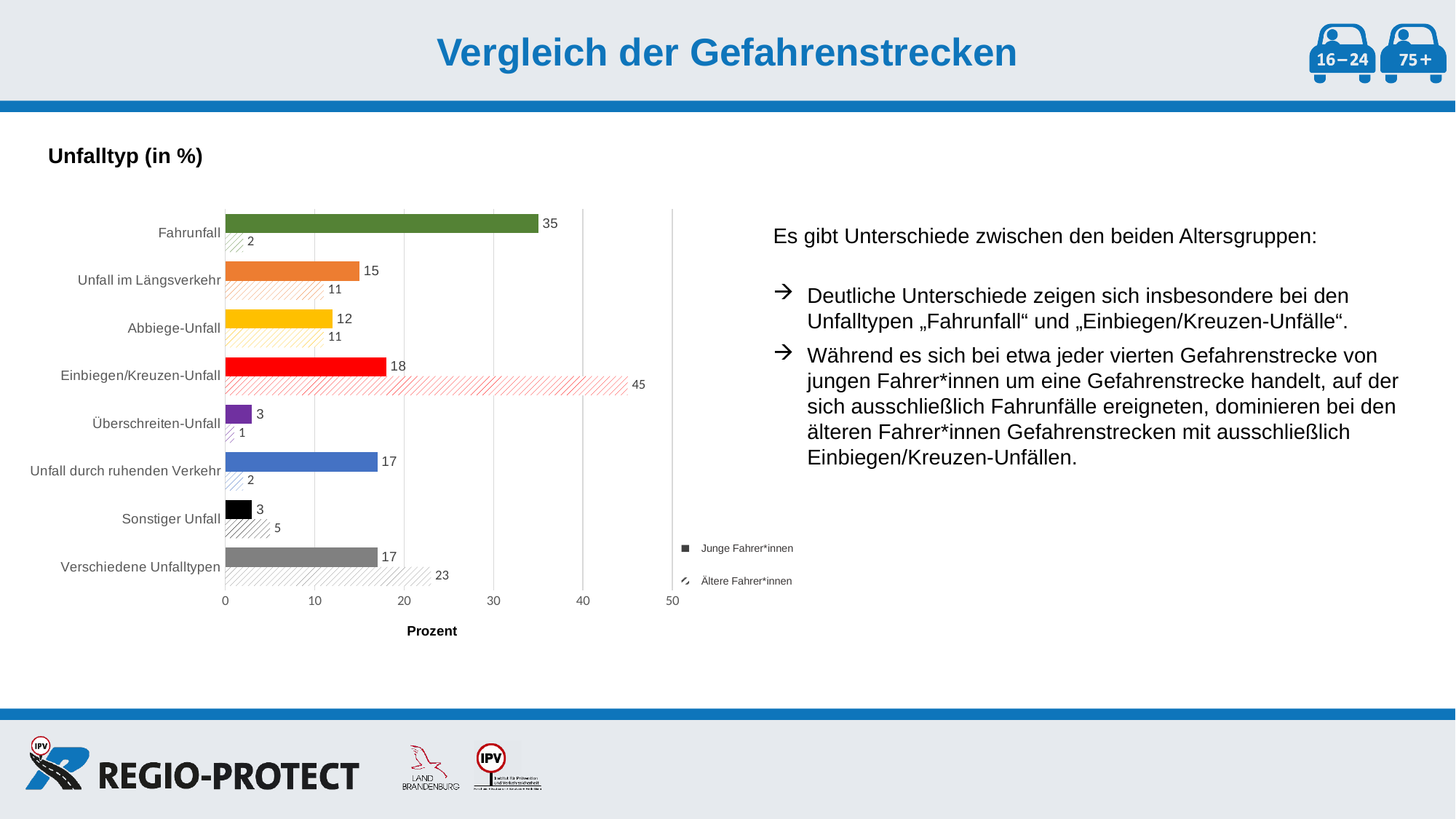
How many accident type categories are shown on the chart? 8 How many series does the legend list? 2 Which is larger for Unfall im Längsverkehr: the value for Junge Fahrer*innen or for Ältere Fahrer*innen? Junge Fahrer*innen What is the value for Fahrunfall for Junge Fahrer*innen? 35 What is the value for Einbiegen/Kreuzen-Unfall for Ältere Fahrer*innen? 45 Which category has the lowest value for Ältere Fahrer*innen? Überschreiten-Unfall Which category has the highest value for Junge Fahrer*innen? Fahrunfall Is the value for Fahrunfall for Junge Fahrer*innen greater or less than 30? greater What is the label of the x axis? Prozent What is the difference between the Ältere Fahrer*innen and Junge Fahrer*innen values for Einbiegen/Kreuzen-Unfall? 27 What is the value for Verschiedene Unfalltypen for Ältere Fahrer*innen? 23 What kind of chart is shown on the slide? Bar chart